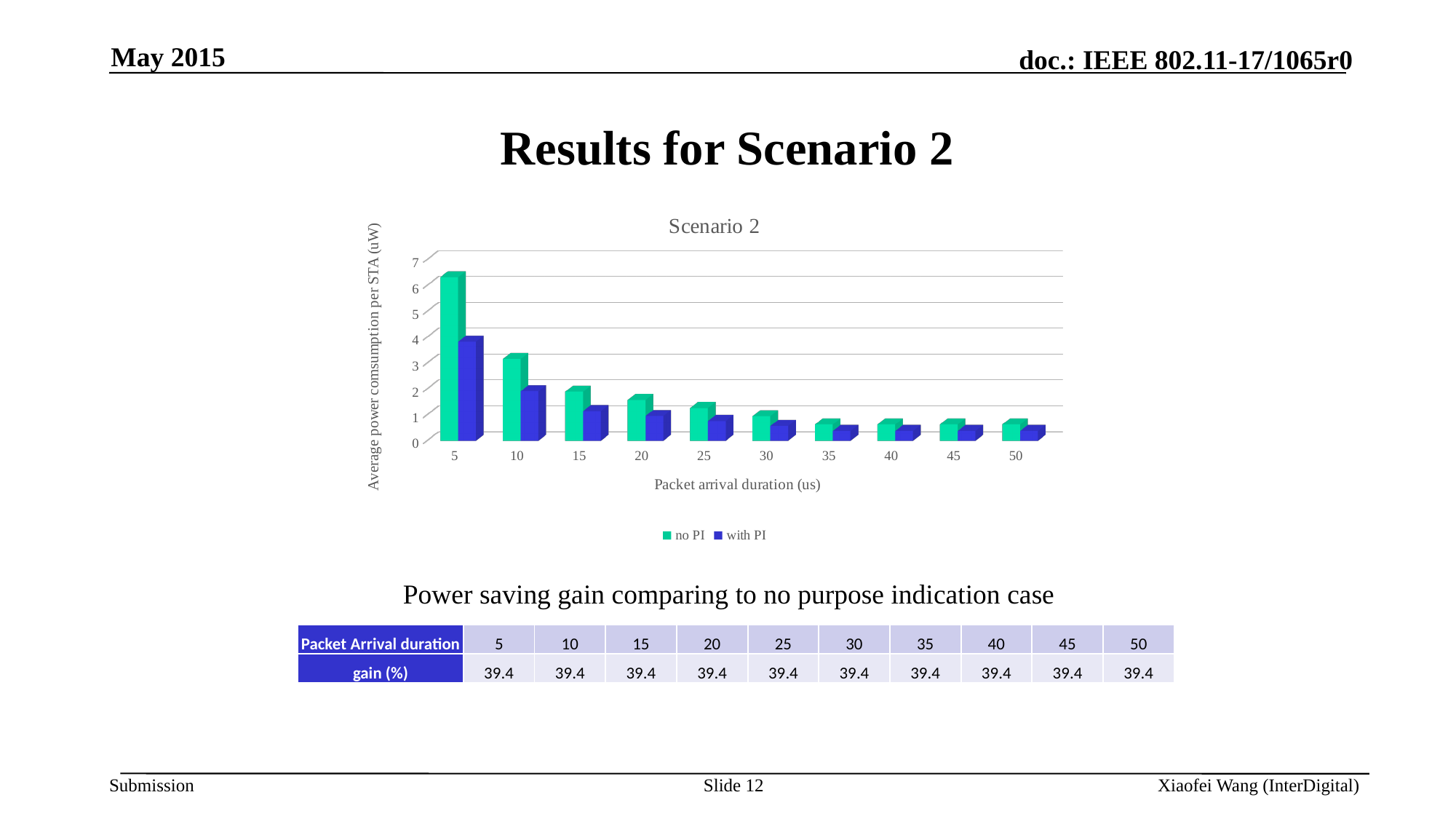
Do the 'no PI' values rise or fall as packet arrival duration increases from 5 to 50? fall Is the 'no PI' value at packet arrival duration 50 greater or less than 1? less How many packet arrival duration categories are plotted on the x axis of the chart? 10 Is the 'no PI' value at packet arrival duration 10 greater or less than 2? greater At which packet arrival duration is the 'no PI' bar highest? 5 At a packet arrival duration of 5, which series has the larger value, 'no PI' or 'with PI'? no PI What is the label of the chart's x axis? Packet arrival duration (us) How many series does the chart legend list? 2 What is the title of the chart? Scenario 2 What kind of chart is shown on the slide? bar chart Is the 'no PI' value at packet arrival duration 5 greater or less than 5? greater